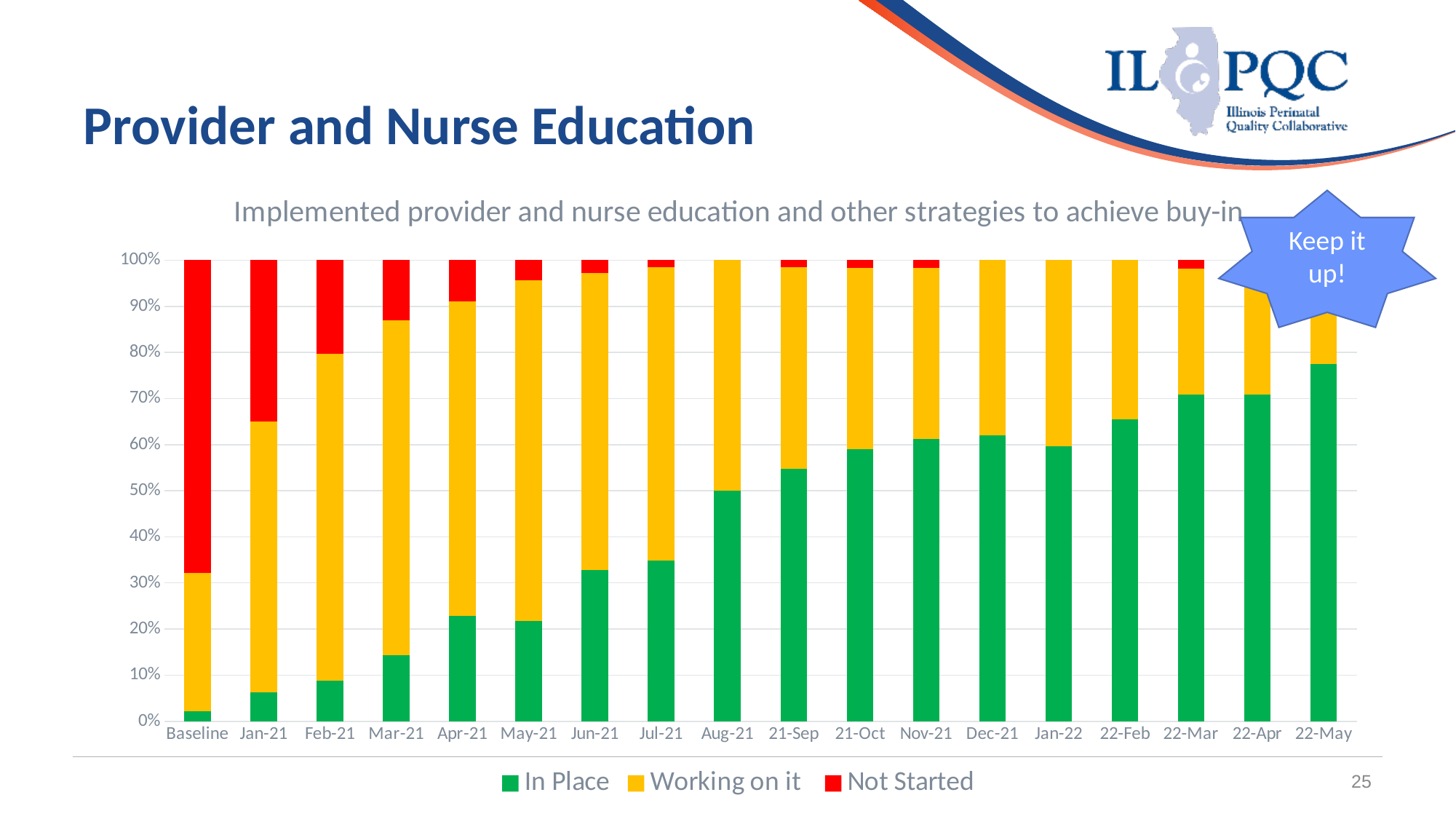
Which colour represents the 'Working on it' series in the legend? Yellow Which category has the largest 'Not Started' segment? Baseline What kind of chart is shown on the slide? Stacked bar chart How many series does the legend list? 3 Which category has the lowest 'In Place' value? Baseline Is the 'In Place' value for 22-May greater or less than 70%? greater How many time-period categories are shown on the x axis? 18 Which has a larger 'Not Started' segment, Baseline or Jan-21? Baseline Is the 'Not Started' share for Baseline greater or less than 60%? greater Does the 'In Place' series generally rise or fall from Baseline to 22-May? Rise Which category has the highest 'In Place' value? 22-May Is the 'In Place' value for Jan-21 greater or less than 10%? less